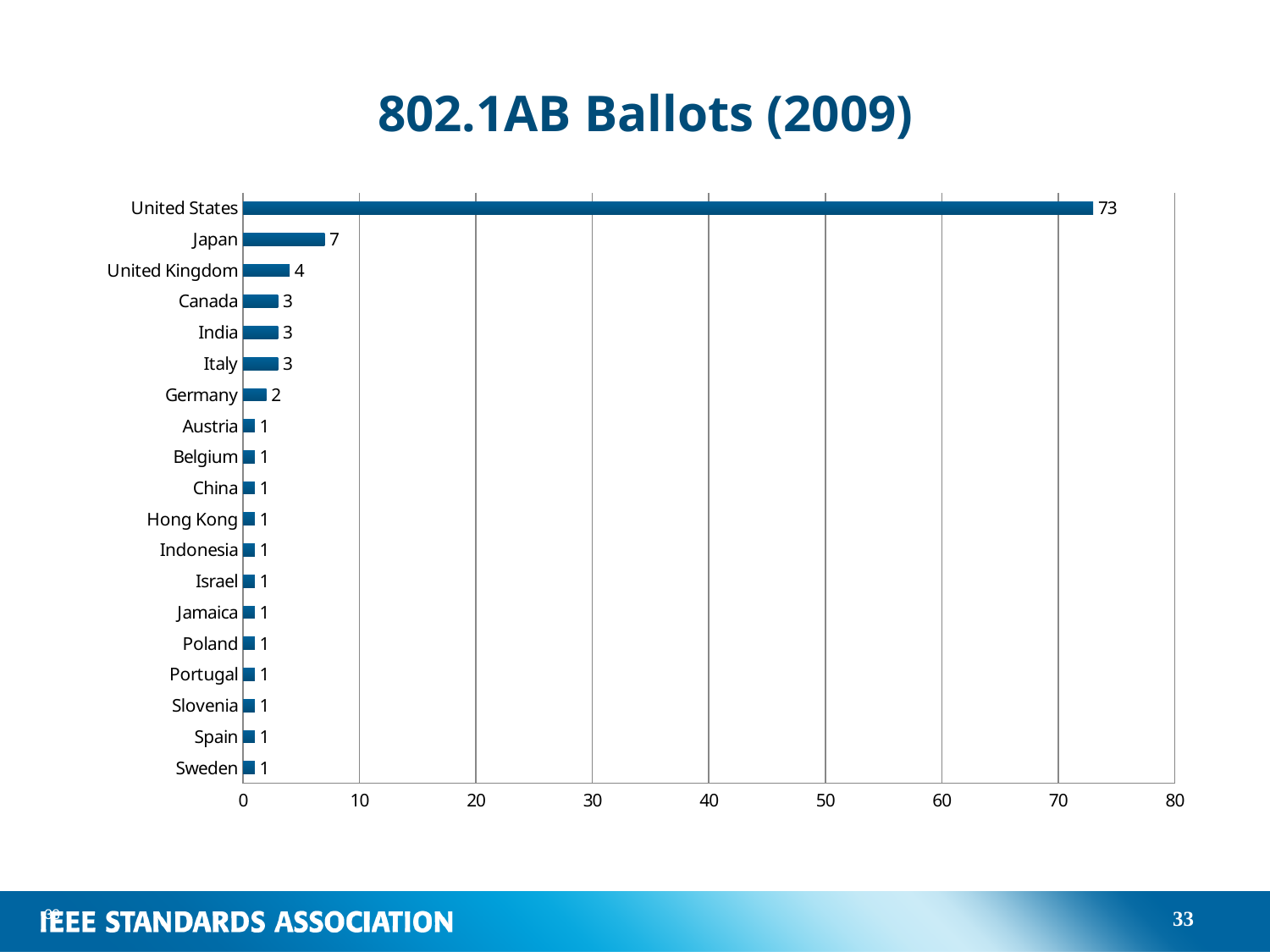
Which is larger, the value for Canada or the value for Germany? Canada Which category has the highest value? United States What is the value for Japan? 7 How many categories are shown in the chart? 19 Is the value for the United States greater or less than 70? greater What is the difference between the values for the United States and Japan? 66 What is the value for the United Kingdom? 4 What is the value for Germany? 2 What is the value for the United States? 73 What is the title of the chart? 802.1AB Ballots (2009) What is the difference between the values for Japan and the United Kingdom? 3 What kind of chart is shown on the slide? bar chart